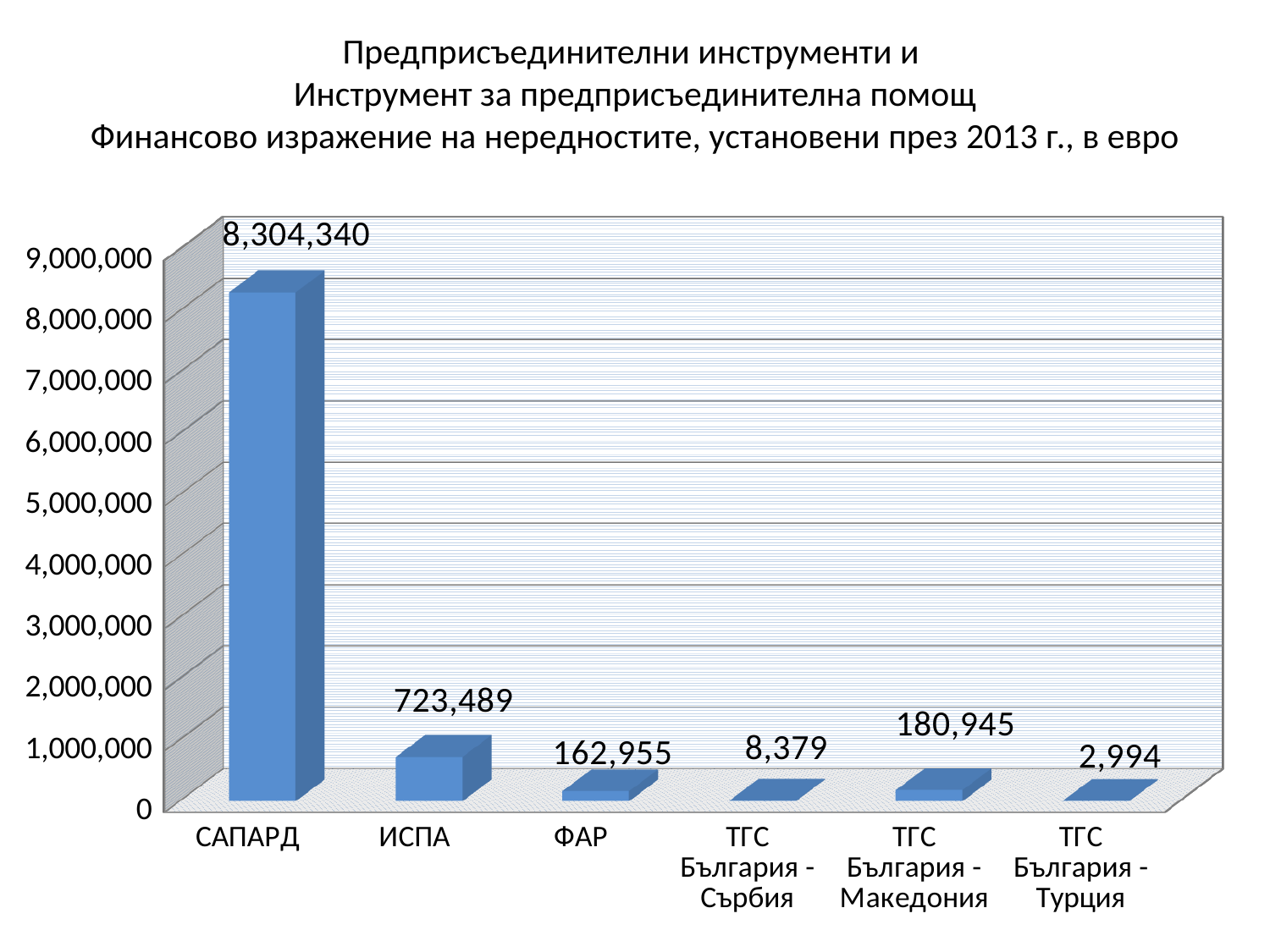
What is the value for САПАРД? 8,304,340 What is the difference between the values for САПАРД and ИСПА? 7,580,851 What is the difference between the values for ТГС България - Македония and ФАР? 17,990 What is the value for ИСПА? 723,489 What is the value for ТГС България - Турция? 2,994 Which category has the lowest value? ТГС България - Турция Which is larger, the value for ФАР or the value for ТГС България - Македония? ТГС България - Македония Is the value for ИСПА greater or less than 1,000,000? less Which category has the highest value? САПАРД How many categories are shown on the x axis? 6 What kind of chart is shown on the slide? bar chart What is the value for ТГС България - Македония? 180,945